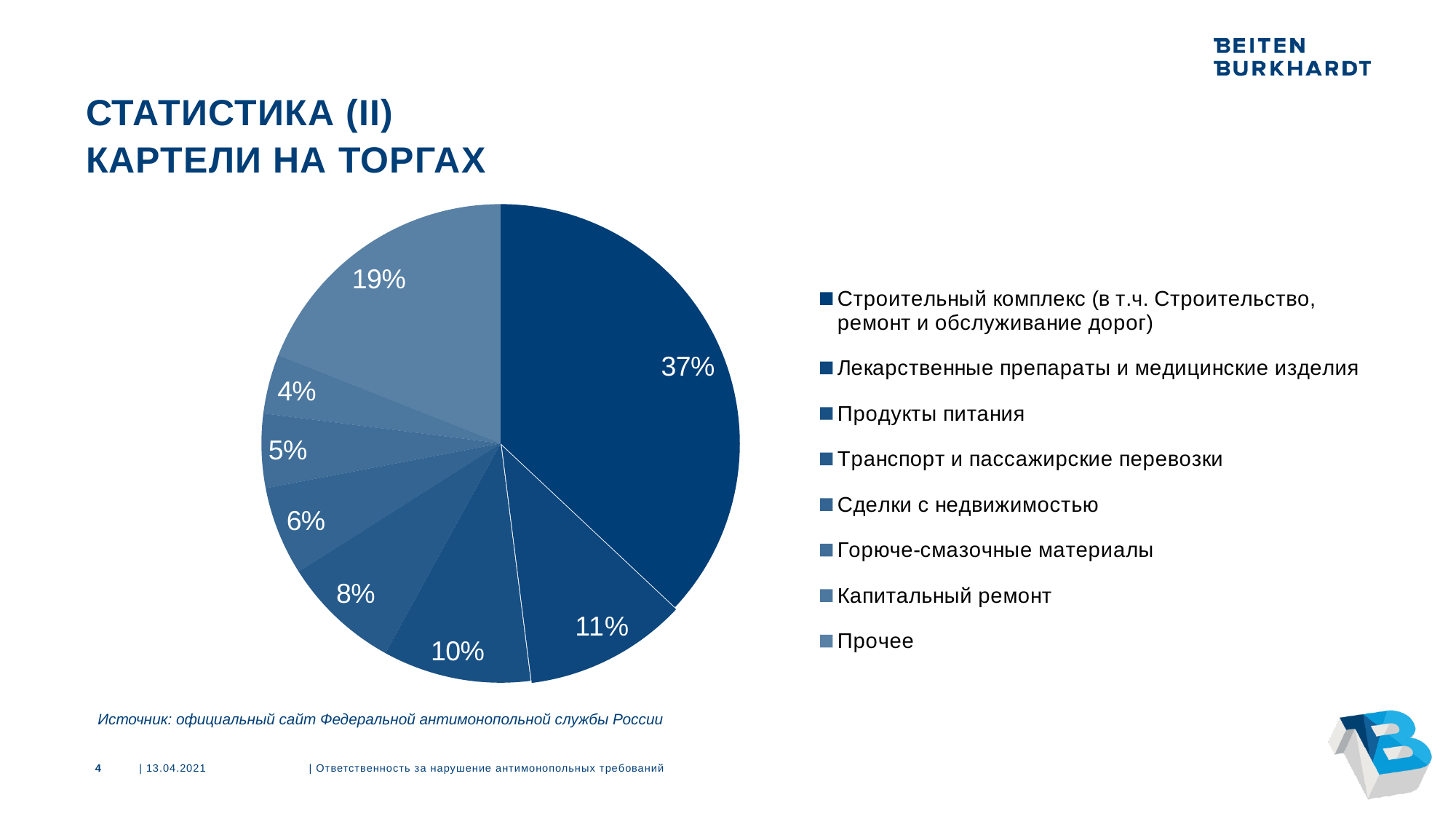
What share of the pie chart does «Строительный комплекс (в т.ч. Строительство, ремонт и обслуживание дорог)» account for? 37% Which category has the largest slice of the pie chart? Строительный комплекс (в т.ч. Строительство, ремонт и обслуживание дорог) What percentage is shown for «Лекарственные препараты и медицинские изделия»? 11% What is the combined share of «Горюче-смазочные материалы» and «Капитальный ремонт»? 9% What is the source cited below the chart? Официальный сайт Федеральной антимонопольной службы России What is the difference in percentage points between «Строительный комплекс» and «Прочее»? 18 Which category has the smallest slice of the pie chart? Капитальный ремонт Which is larger: the share for «Продукты питания» or the share for «Сделки с недвижимостью»? Продукты питания What percentage is shown for «Транспорт и пассажирские перевозки»? 8% How many slices does the pie chart have? 8 What type of chart is shown on the slide? Pie chart What percentage is shown for «Прочее»? 19%